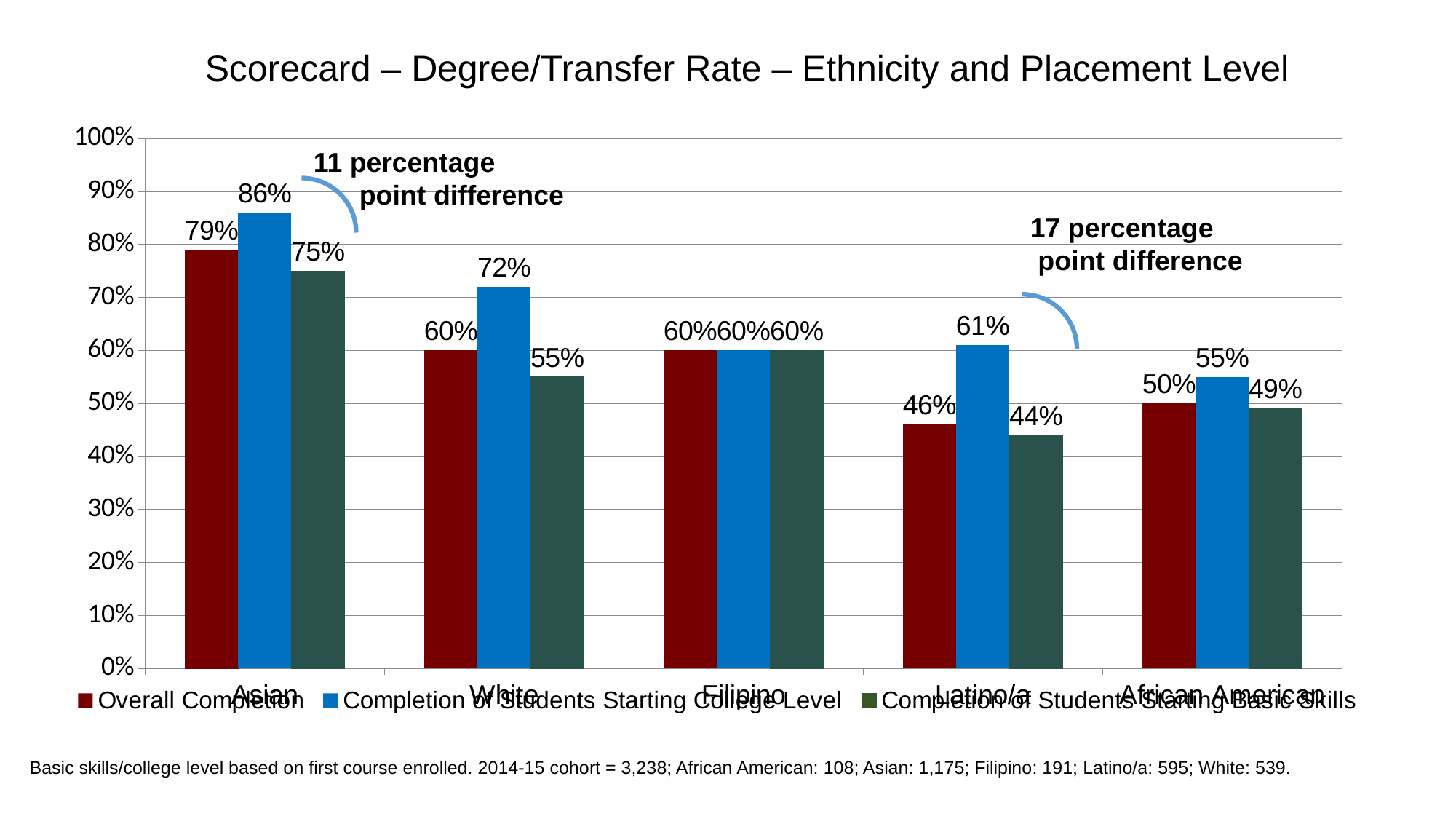
Which ethnicity has the highest Completion of Students Starting College Level rate? Asian What kind of chart is shown on the slide? Bar chart What is the difference between the Completion of Students Starting College Level rate and the Completion of Students Starting Basic Skills rate for Asian students? 11 percentage points What is the Completion of Students Starting College Level rate for White students? 72% What is the Completion of Students Starting Basic Skills rate for Latino/a students? 44% What is the difference between the Completion of Students Starting College Level rate and the Completion of Students Starting Basic Skills rate for Latino/a students? 17 percentage points What is the Overall Completion rate for Asian students? 79% How many ethnicity categories are shown on the x axis? 5 What is the title of the chart? Scorecard – Degree/Transfer Rate – Ethnicity and Placement Level Which is larger for African American students: Overall Completion or Completion of Students Starting Basic Skills? Overall Completion Which ethnicity has the lowest Overall Completion rate? Latino/a How many series does the legend list? 3